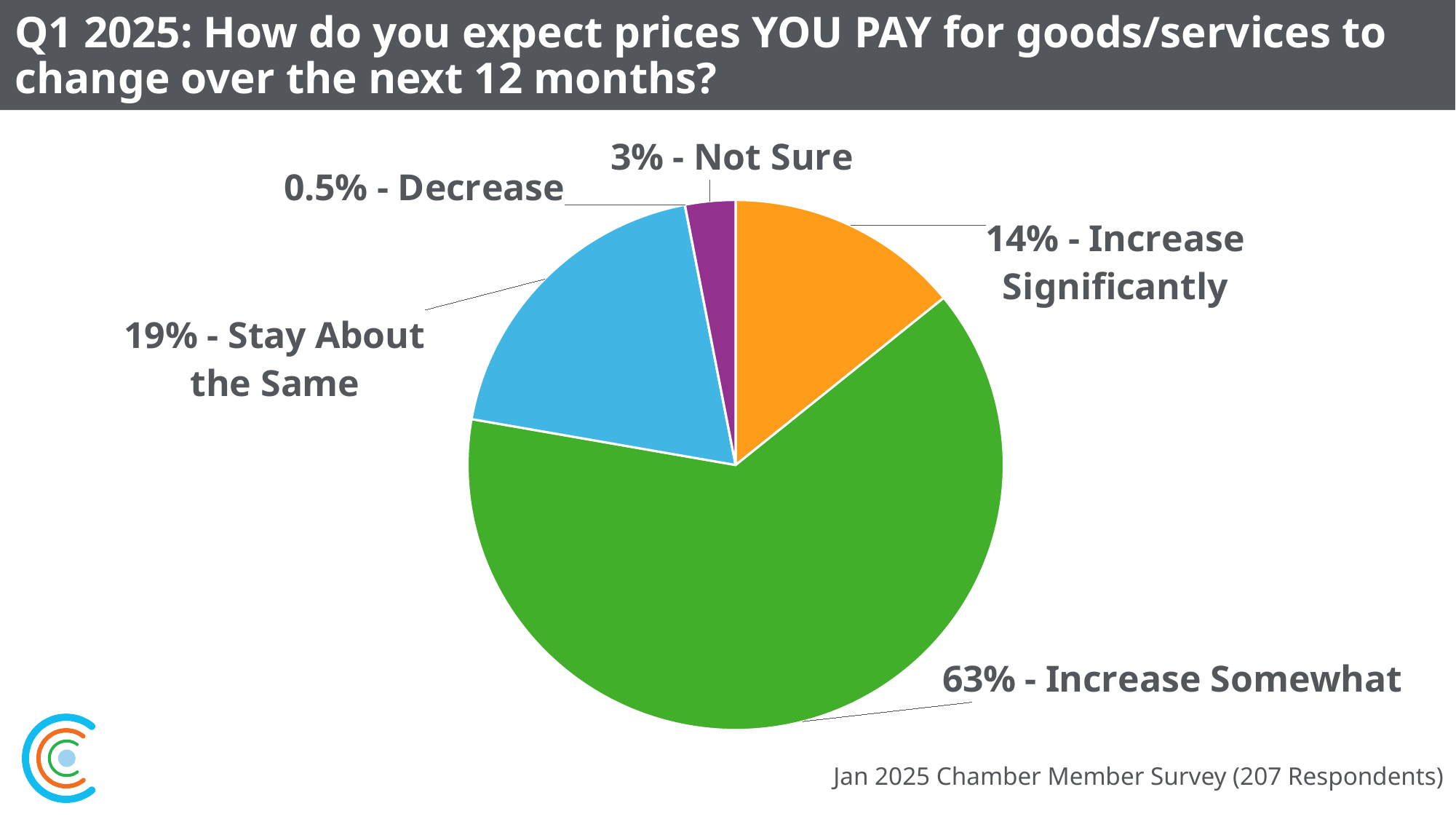
What colour is the Increase Somewhat slice? Green Which response has the largest slice of the pie? Increase Somewhat Which response has the smallest slice of the pie? Decrease Which is larger: the share for Stay About the Same or the share for Increase Significantly? Stay About the Same What share of respondents expect prices to stay about the same? 19% What share of respondents expect prices to increase significantly? 14% What share of respondents expect prices to decrease? 0.5% How many slices does the pie chart have? 5 What kind of chart is shown on the slide? Pie chart What is the difference in percentage points between Increase Somewhat and Stay About the Same? 44